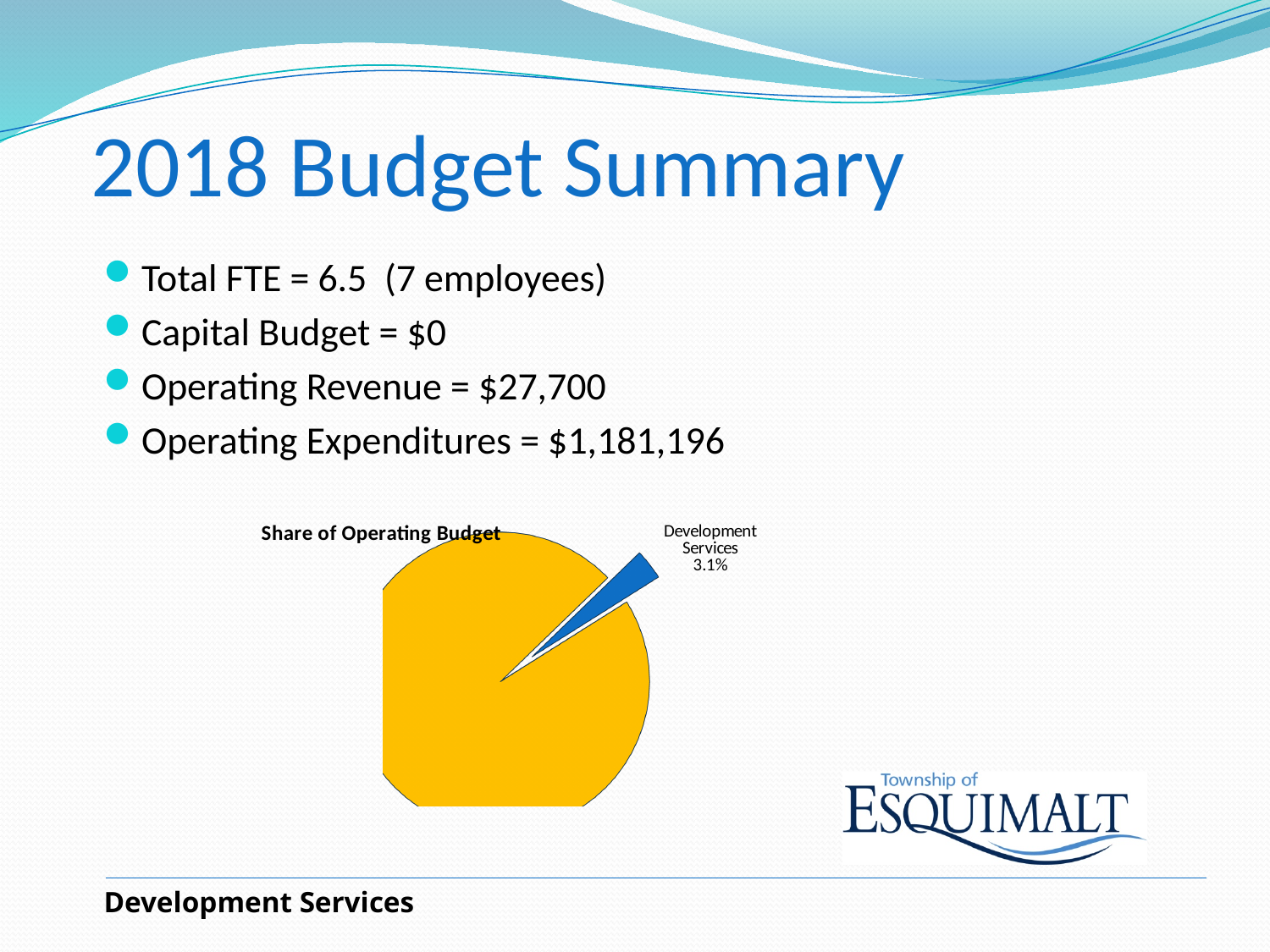
How many slices does the Share of Operating Budget pie chart have? 2 In the Share of Operating Budget pie chart, what share of the pie is not Development Services? 96.9% What is the title of the chart on the slide? Share of Operating Budget In the Share of Operating Budget pie chart, which slice is larger: the Development Services slice or the unlabelled yellow slice? the unlabelled yellow slice What colour is the Development Services slice in the Share of Operating Budget pie chart? blue What kind of chart is shown on the slide? pie chart In the Share of Operating Budget pie chart, which slice is the smallest? Development Services In the Share of Operating Budget pie chart, what share is labelled for Development Services? 3.1%